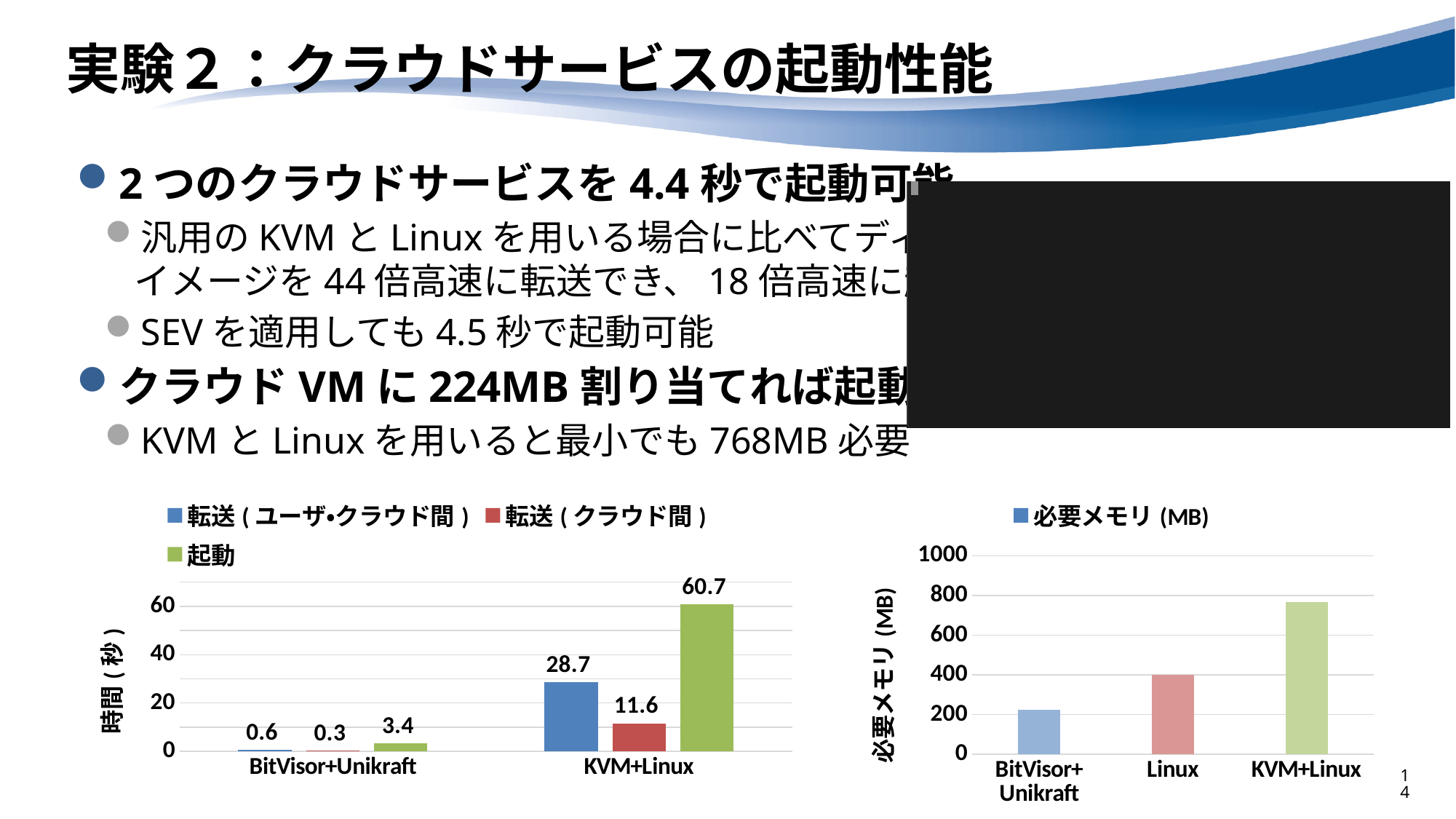
In the left chart, what is the 転送 ( ユーザ•クラウド間 ) value for BitVisor+Unikraft? 0.6 In the right chart (必要メモリ (MB)), is the value for Linux greater or less than 600? less In the left chart, what is the 起動 value for KVM+Linux? 60.7 In the right chart (必要メモリ (MB)), which category has the highest value? KVM+Linux In the left chart, which series has the highest value for KVM+Linux? 起動 How many series does the legend of the left chart list? 3 In the left chart, what is the 転送 ( クラウド間 ) value for KVM+Linux? 11.6 In the right chart (必要メモリ (MB)), is the value for KVM+Linux greater or less than 600? greater What kind of chart is the right chart (必要メモリ (MB))? bar chart In the left chart, what is the difference between the 起動 values for KVM+Linux and BitVisor+Unikraft? 57.3 In the left chart, which series has the lowest value for BitVisor+Unikraft? 転送 ( クラウド間 ) How many categories are shown on the x axis of the right chart (必要メモリ (MB))? 3